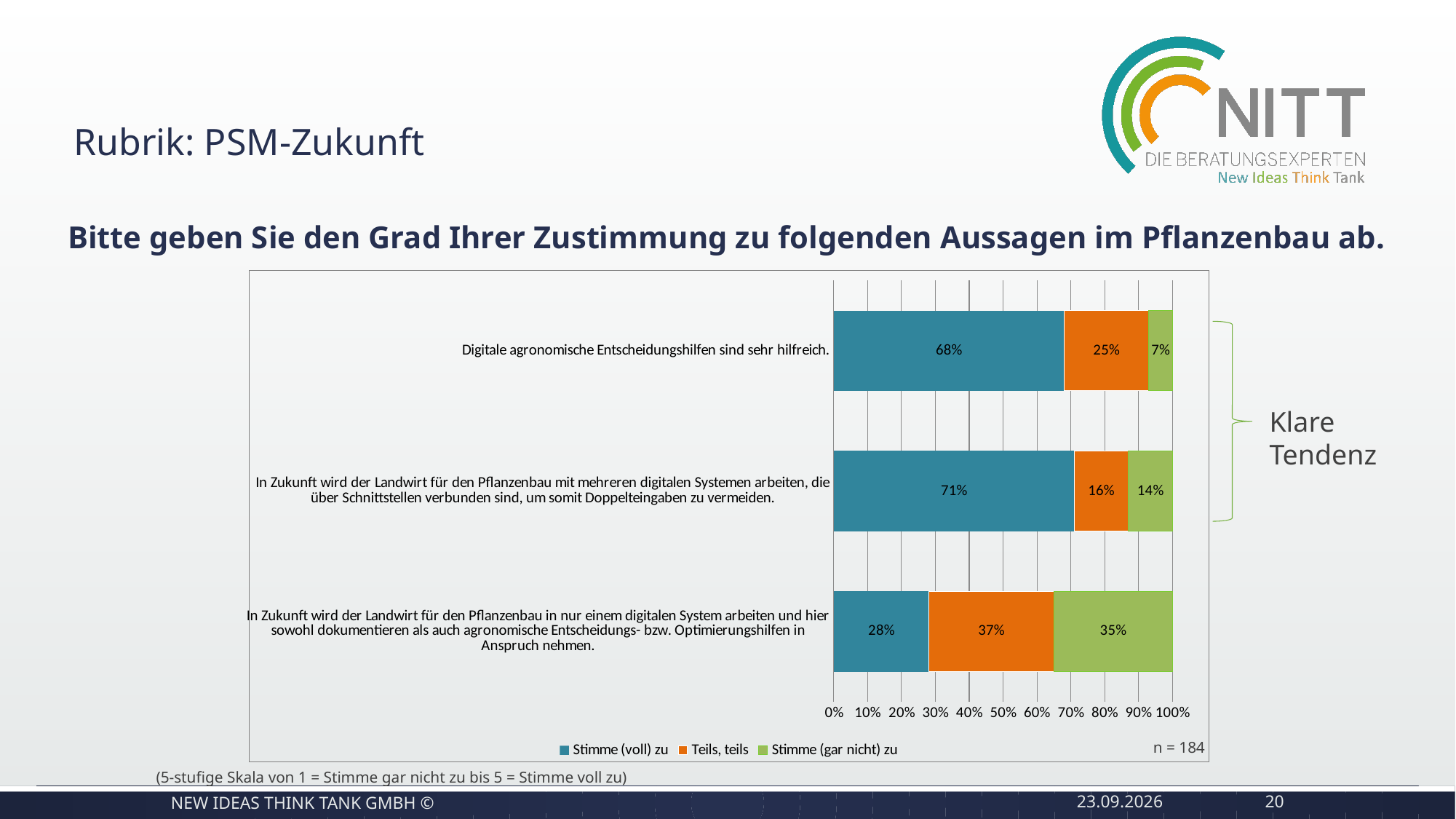
For the statement about working in only one digital system, which is larger: the "Teils, teils" share or the "Stimme (voll) zu" share? Teils, teils How many series does the legend list? 3 Which colour represents "Teils, teils" in the chart? Orange Which statement has the lowest "Stimme (gar nicht) zu" share? Digitale agronomische Entscheidungshilfen sind sehr hilfreich. How many statements are shown in the chart? 3 Which statement has the highest "Stimme (voll) zu" share? In Zukunft wird der Landwirt für den Pflanzenbau mit mehreren digitalen Systemen arbeiten, die über Schnittstellen verbunden sind, um somit Doppelteingaben zu vermeiden. What is the "Teils, teils" share for the statement about working with several digital systems connected via interfaces? 16% What is the sample size (n) given on the chart? n = 184 What percentage of respondents answered "Stimme (voll) zu" to the statement "Digitale agronomische Entscheidungshilfen sind sehr hilfreich."? 68% What is the "Stimme (gar nicht) zu" share for the statement about working in only one digital system? 35% What kind of chart is shown on the slide? Stacked bar chart What is the difference between the "Stimme (voll) zu" shares for the statement about several digital systems and the statement about only one digital system? 43%